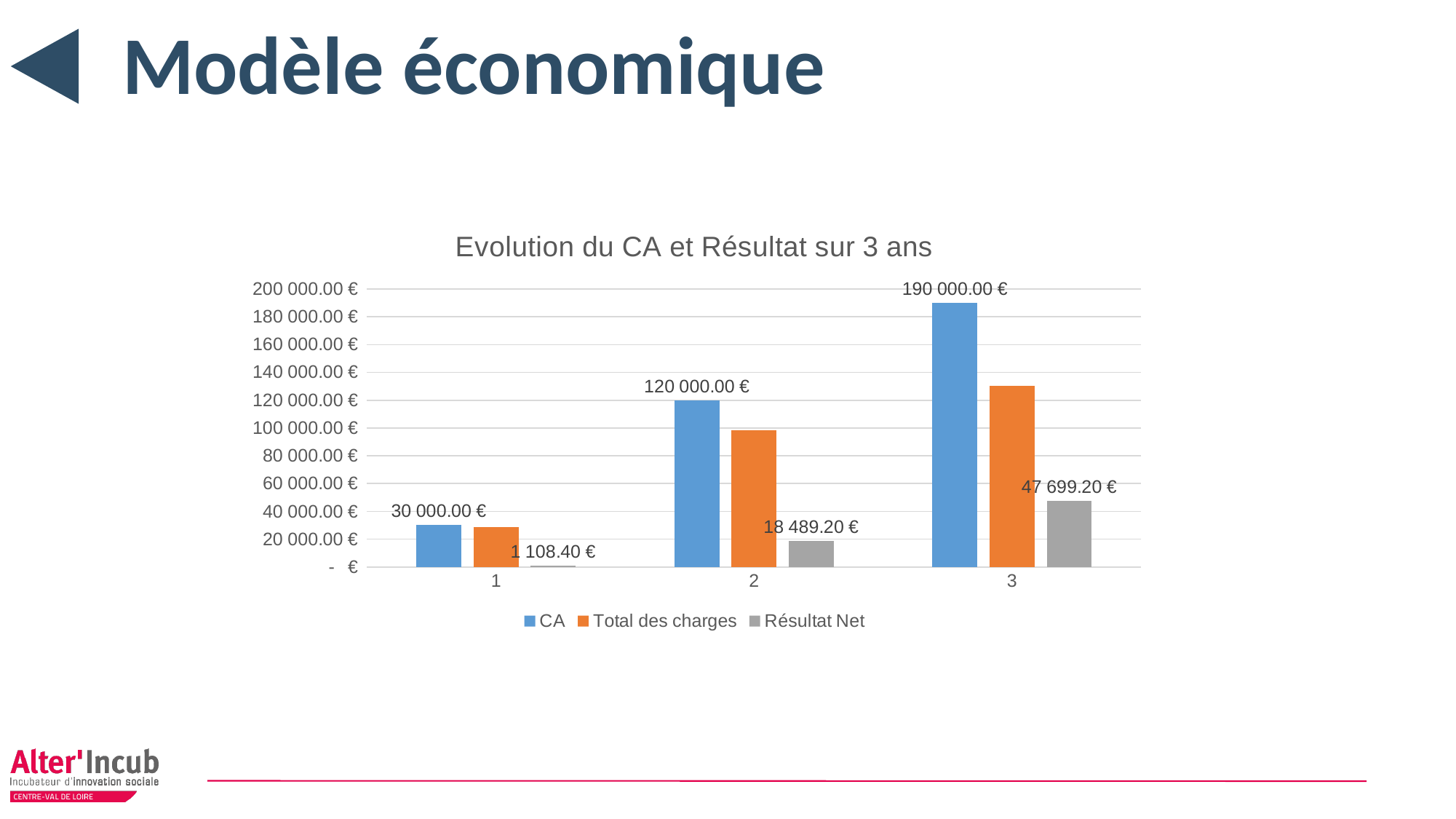
Does the CA rise or fall from category 1 to category 3? rise Which is larger for category 2: CA or Résultat Net? CA What is the Résultat Net for category 2? 18 489.20 € What is the value of CA for category 3? 190 000.00 € What is the difference between the CA for category 3 and the CA for category 1? 160 000.00 € How many series does the legend list? 3 What kind of chart is shown on the slide? bar chart Is the value of Total des charges for category 3 greater or less than 120 000.00 €? greater How many categories are shown on the x axis? 3 Which category has the lowest Résultat Net? 1 What is the Résultat Net for category 1? 1 108.40 € Which category has the highest CA? 3